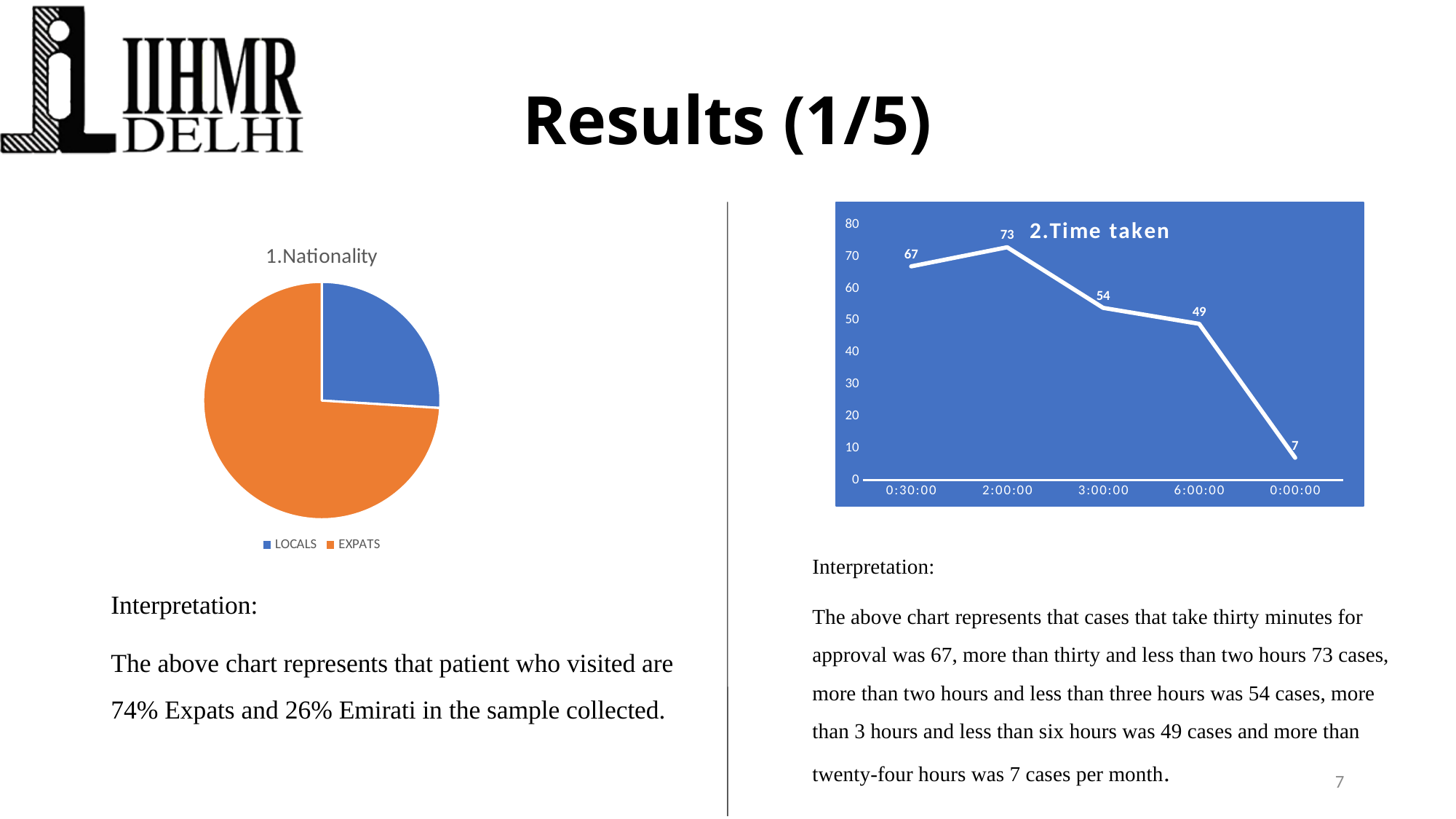
In the '2.Time taken' chart, what is the value at 3:00:00? 54 In the '2.Time taken' chart, what is the value at 0:30:00? 67 In the '2.Time taken' chart, what is the difference between the values at 2:00:00 and 6:00:00? 24 In the '2.Time taken' chart, what is the value at 0:00:00? 7 How many entries does the legend of the '1.Nationality' chart list? 2 In the '2.Time taken' chart, which x-axis category has the highest value? 2:00:00 In the '1.Nationality' pie chart, which slice is larger: LOCALS or EXPATS? EXPATS How many data points are plotted in the '2.Time taken' chart? 5 In the '2.Time taken' chart, which is larger: the value at 0:30:00 or the value at 3:00:00? 0:30:00 What type of chart is '2.Time taken'? line chart In the '2.Time taken' chart, do the values generally rise or fall from 2:00:00 to 0:00:00 along the x axis? fall In the '2.Time taken' chart, which x-axis category has the lowest value? 0:00:00